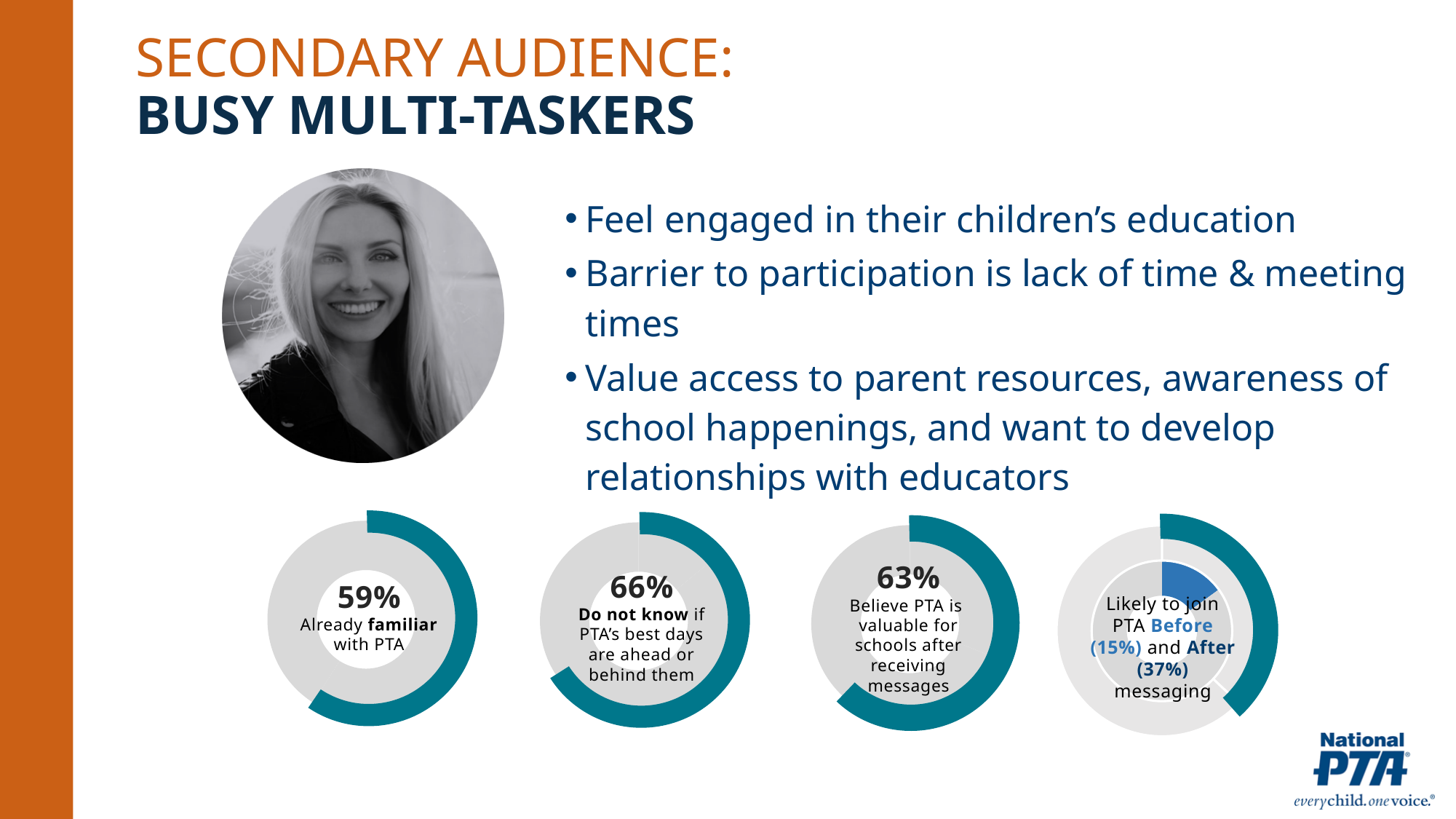
Which of the three single-value donut charts on the left shows the highest percentage? 66% (Do not know if PTA's best days are ahead or behind them) On the second donut chart from the left, what percentage do not know if PTA's best days are ahead or behind them? 66% On the rightmost donut chart, what percentage are likely to join PTA before messaging? 15% What is the difference between the percentage who do not know if PTA's best days are ahead or behind them and the percentage already familiar with PTA? 7% On the rightmost donut chart, what percentage are likely to join PTA after messaging? 37% On the leftmost donut chart, what percentage are already familiar with PTA? 59% On the third donut chart from the left, what percentage believe PTA is valuable for schools after receiving messages? 63% How many donut charts are shown on the slide? 4 What type of chart is used to show the percentages at the bottom of the slide? Donut (pie) chart Which of the three single-value donut charts on the left shows the lowest percentage? 59% (Already familiar with PTA) On the rightmost donut chart, what is the difference between the after-messaging and before-messaging percentages? 22% On the rightmost donut chart, which is larger: the before-messaging or the after-messaging percentage? After (37%)